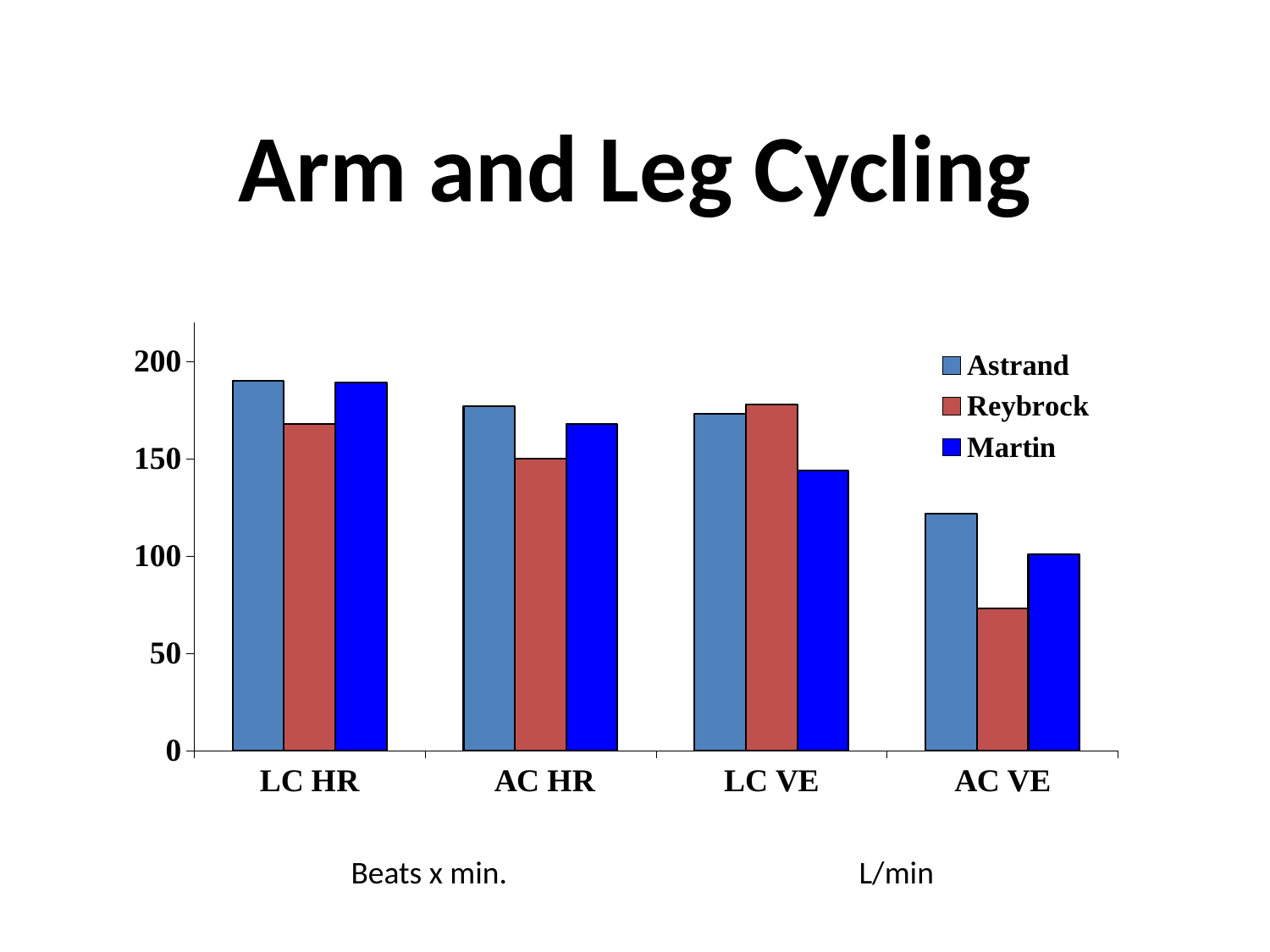
Is the Reybrock value for AC VE greater or less than 100? less How many series does the legend list? 3 What kind of chart is shown on the slide? bar chart Do the Astrand values rise or fall from LC HR to AC VE along the x axis? fall For LC VE, which is larger, the Reybrock value or the Martin value? Reybrock In which category is the Reybrock value lowest? AC VE Is the Martin value for AC HR greater or less than 150? greater Is the Astrand value for AC VE greater or less than 100? greater What is the title of the slide? Arm and Leg Cycling How many categories are shown on the x axis? 4 For AC VE, which is larger, the Astrand value or the Reybrock value? Astrand Which series are listed in the legend? Astrand, Reybrock, Martin